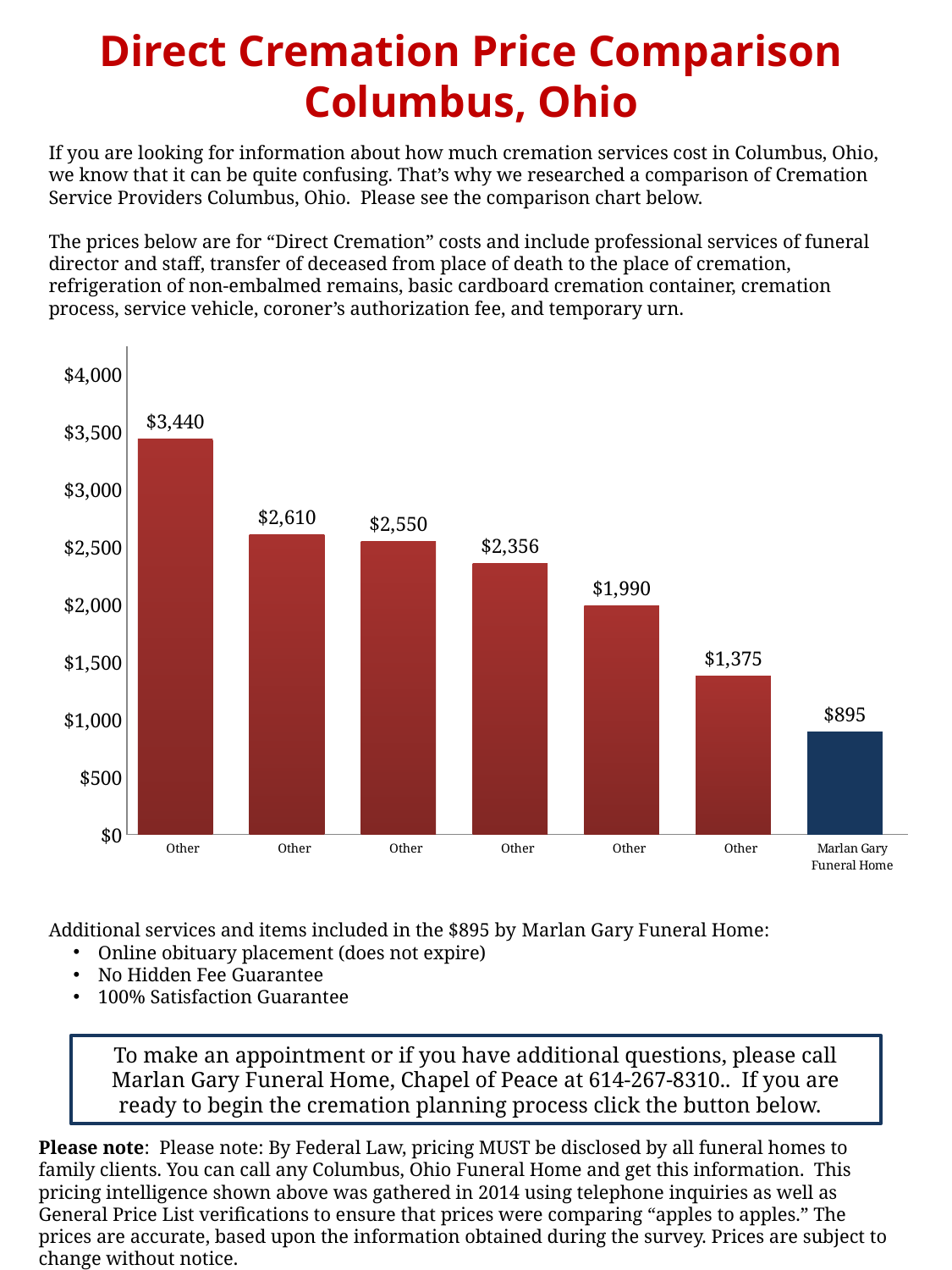
Do the bar values rise or fall from left to right across the chart? Fall What kind of chart is shown on the slide? Bar chart Is the value of the third bar from the left greater or less than $2,500? greater Which provider has the lowest direct cremation price in the chart? Marlan Gary Funeral Home What is the value of the fourth bar from the left? $2,356 What is the difference between the highest price ($3,440) and the Marlan Gary Funeral Home price? $2,545 What colour is the bar for Marlan Gary Funeral Home, compared with the other bars? Dark blue (the others are red) Which is larger: the value of the fifth bar from the left or the value of the sixth bar from the left? The fifth bar ($1,990) How many bars are shown in the chart? 7 What is the value of the second bar from the left? $2,610 What is the direct cremation price shown for Marlan Gary Funeral Home? $895 What is the value of the tallest bar in the chart? $3,440